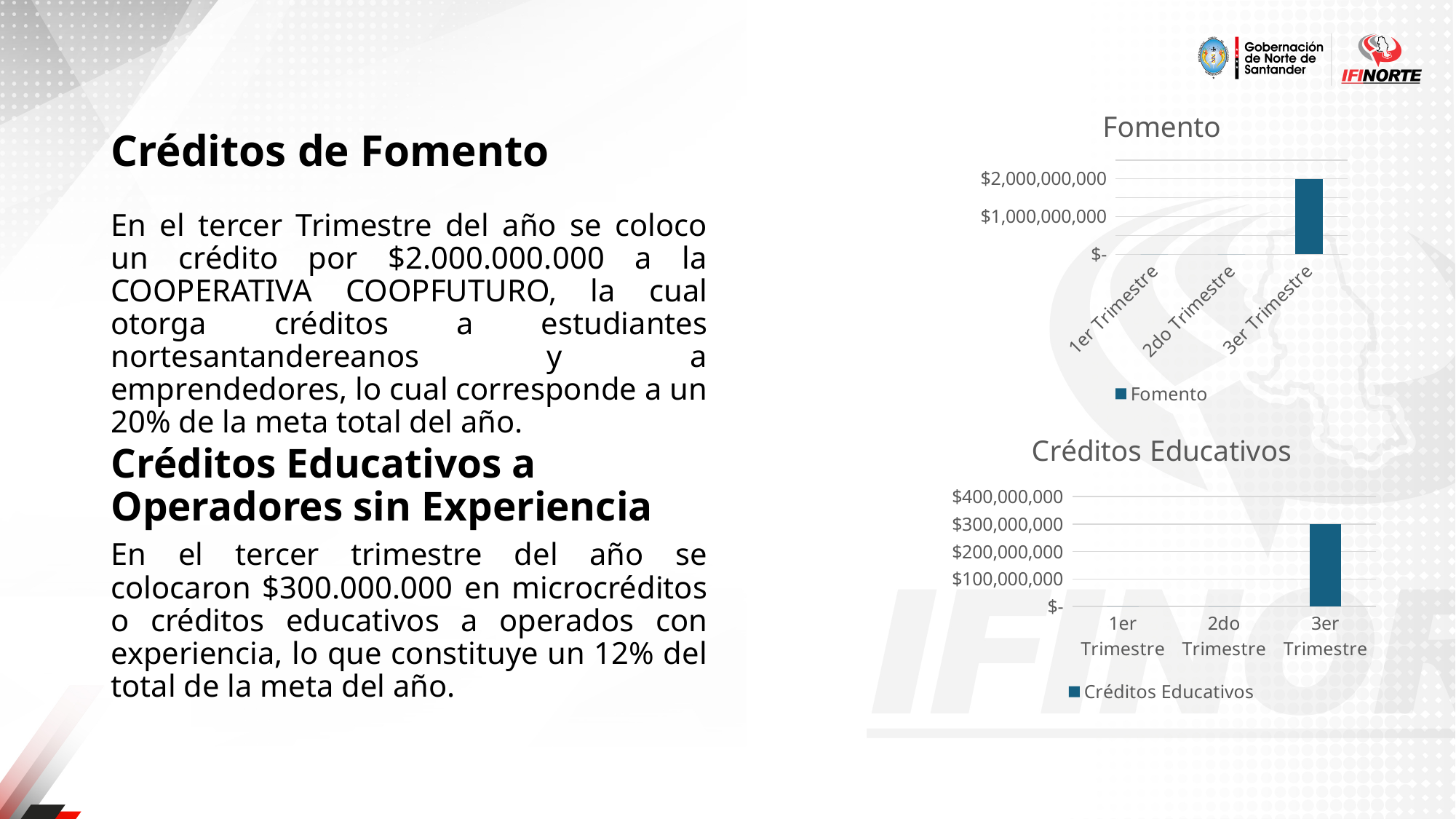
How many categories are shown on the x axis of the Créditos Educativos chart? 3 What kind of chart is the Fomento chart? Bar chart How many categories are shown on the x axis of the Fomento chart? 3 How many series does the legend of the Fomento chart list? 1 In the Créditos Educativos chart, what is the value for 3er Trimestre? $300,000,000 In the Fomento chart, which quarter has the highest value? 3er Trimestre In the Créditos Educativos chart, which quarter has the highest value? 3er Trimestre In the Créditos Educativos chart, is the value for 3er Trimestre greater or less than $200,000,000? greater In the Fomento chart, is the value for 3er Trimestre greater or less than $1,000,000,000? greater In the Fomento chart, what is the value for 3er Trimestre? $2,000,000,000 What is the legend entry of the Créditos Educativos chart? Créditos Educativos What kind of chart is the Créditos Educativos chart? Bar chart